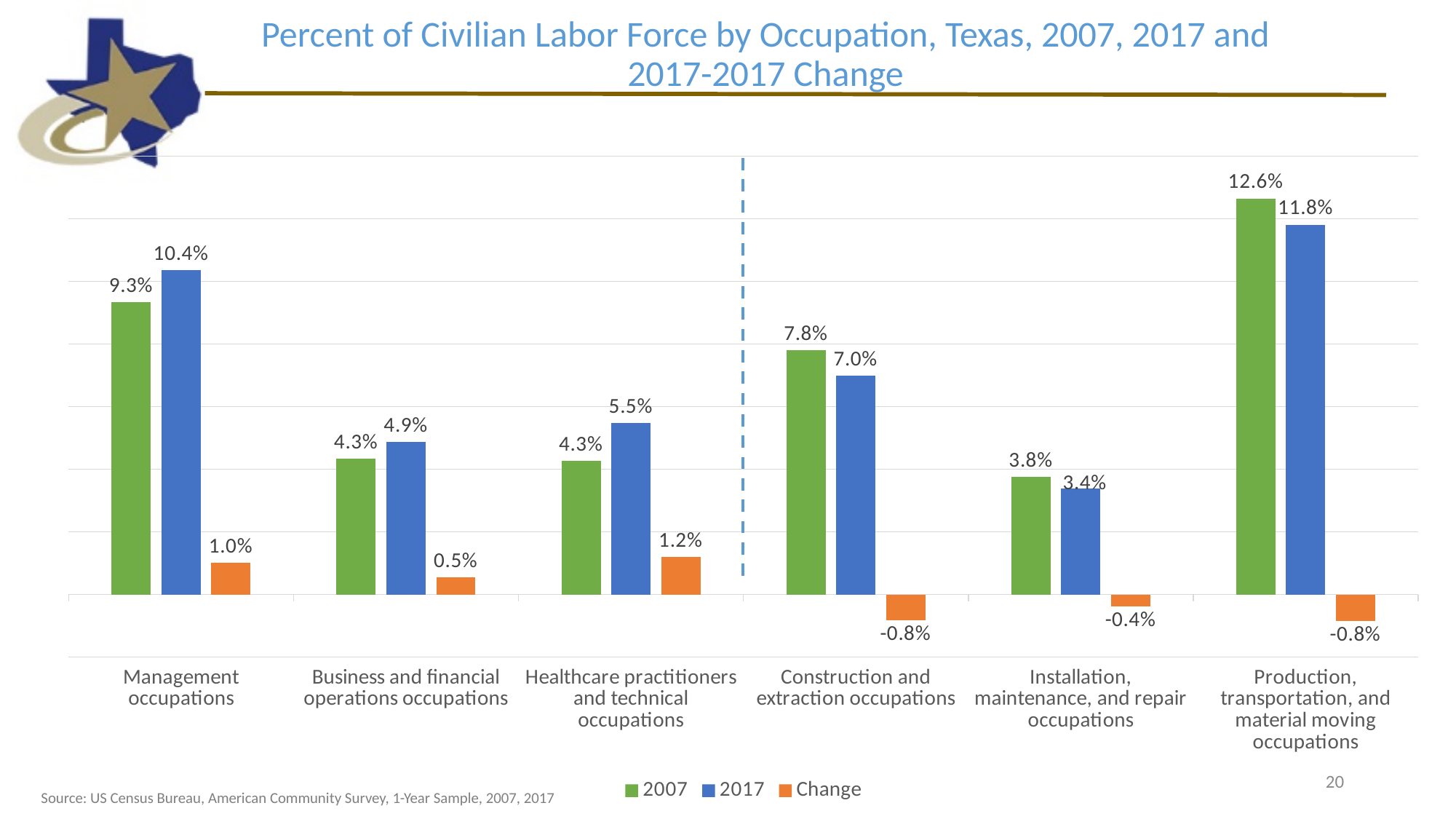
What is the Change value for Construction and extraction occupations? -0.8% Which occupation category has the lowest 2007 value? Installation, maintenance, and repair occupations What is the Change value for Healthcare practitioners and technical occupations? 1.2% What was the 2007 value for Construction and extraction occupations? 7.8% What type of chart is shown on the slide? Bar chart How many series does the legend list? 3 How many occupation categories are shown on the chart? 6 What was the 2017 value for Management occupations? 10.4% What is the difference between the 2007 and 2017 values for Production, transportation, and material moving occupations? 0.8% Which is larger for Installation, maintenance, and repair occupations: the 2007 value or the 2017 value? 2007 Which colour represents the Change series in the chart? Orange Which occupation category has the highest 2017 value? Production, transportation, and material moving occupations